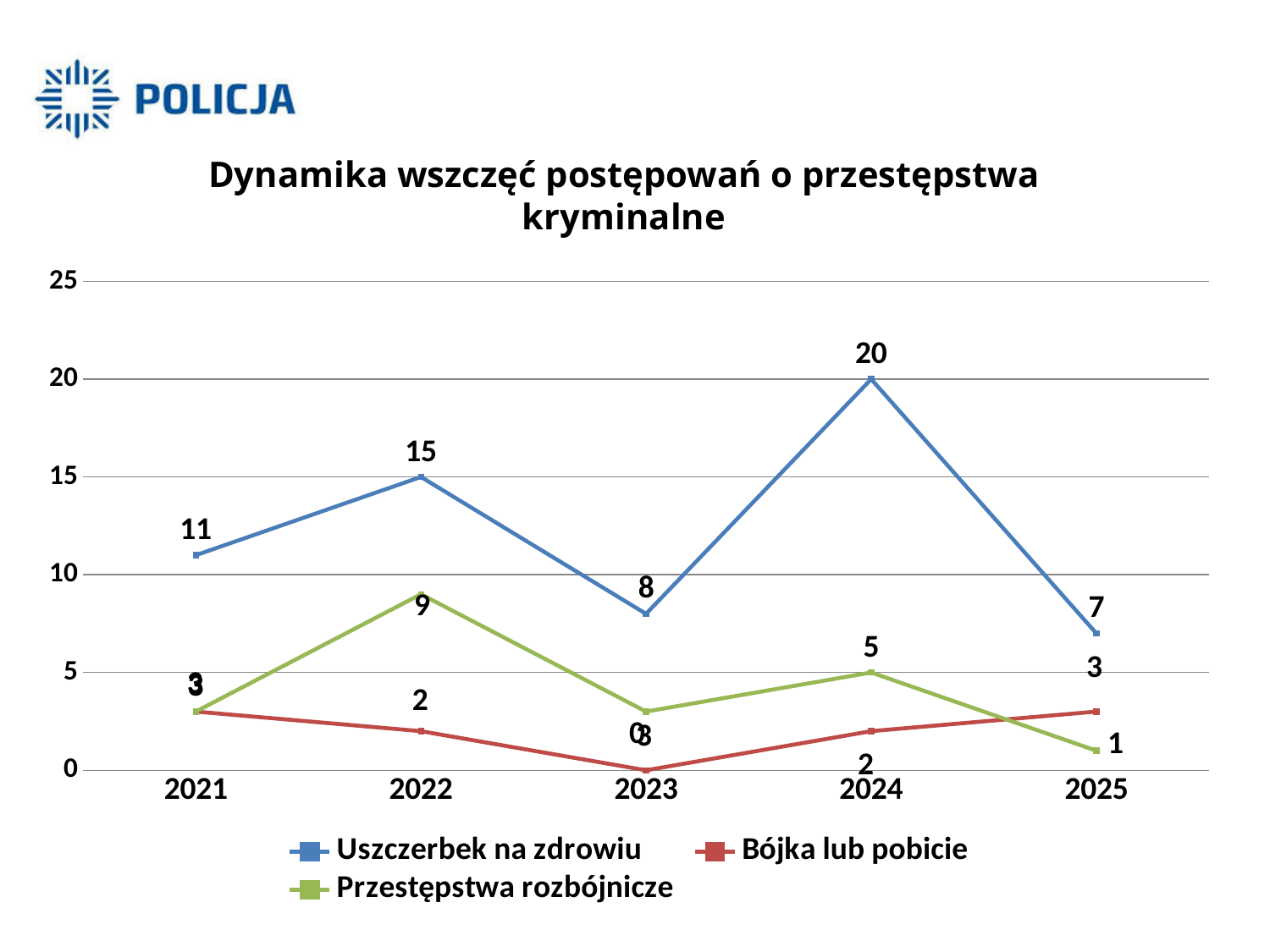
What is the title of the chart? Dynamika wszczęć postępowań o przestępstwa kryminalne What is the difference between Uszczerbek na zdrowiu in 2024 and in 2025? 13 What is the value for Bójka lub pobicie in 2025? 3 In which year is Uszczerbek na zdrowiu lowest? 2025 What is the value for Przestępstwa rozbójnicze in 2022? 9 How many series does the legend list? 3 Does Przestępstwa rozbójnicze rise or fall from 2024 to 2025? fall Which is larger in 2022: Uszczerbek na zdrowiu or Przestępstwa rozbójnicze? Uszczerbek na zdrowiu What type of chart is shown on the slide? line chart In which year is Uszczerbek na zdrowiu highest? 2024 What is the value for Uszczerbek na zdrowiu in 2024? 20 How many years are shown on the x axis? 5